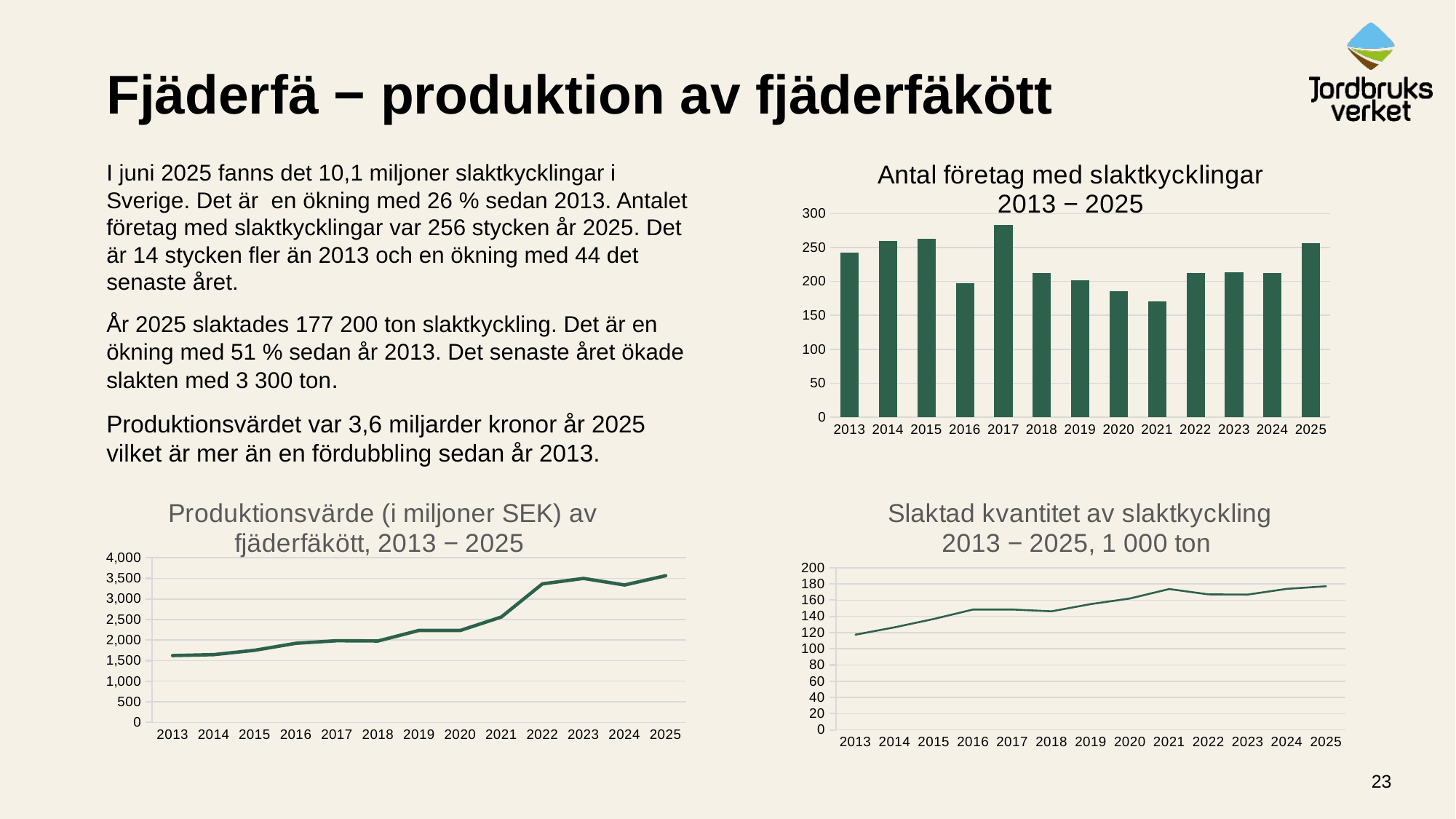
In the chart 'Slaktad kvantitet av slaktkyckling 2013 − 2025, 1 000 ton', is the value for 2025 greater or less than 160? greater What kind of chart is 'Antal företag med slaktkycklingar 2013 − 2025'? bar chart In the chart 'Antal företag med slaktkycklingar 2013 − 2025', which year has the lowest value? 2021 What kind of chart is 'Produktionsvärde (i miljoner SEK) av fjäderfäkött, 2013 − 2025'? line chart In the chart 'Produktionsvärde (i miljoner SEK) av fjäderfäkött, 2013 − 2025', is the value for 2025 greater or less than 3,000? greater In the chart 'Produktionsvärde (i miljoner SEK) av fjäderfäkött, 2013 − 2025', do the values generally rise or fall from 2013 to 2025? rise In the chart 'Antal företag med slaktkycklingar 2013 − 2025', which is larger, the value for 2014 or the value for 2016? 2014 How many years are shown in the chart 'Antal företag med slaktkycklingar 2013 − 2025'? 13 In the chart 'Antal företag med slaktkycklingar 2013 − 2025', is the value for 2020 greater or less than 200? less In the chart 'Antal företag med slaktkycklingar 2013 − 2025', which year has the highest value? 2017 In the chart 'Slaktad kvantitet av slaktkyckling 2013 − 2025, 1 000 ton', which year has the lowest value? 2013